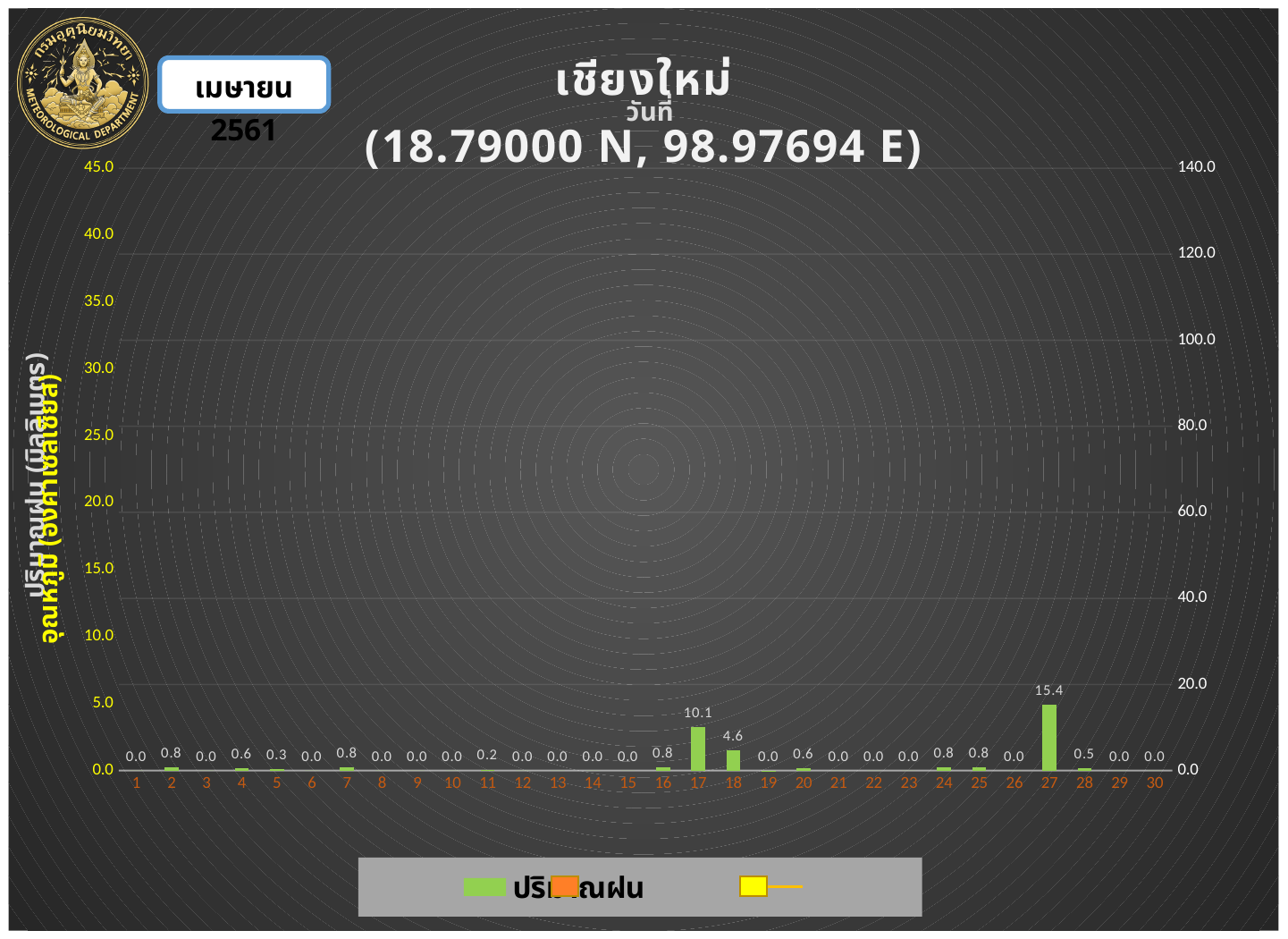
What coordinates are given in the chart title? 18.79000 N, 98.97694 E What kind of chart is shown on the slide? bar chart Which day has the larger rainfall value, day 17 or day 18? 17 What is the rainfall value shown for day 11? 0.2 What is the difference between the rainfall values for day 27 and day 17? 5.3 What is the difference between the rainfall values for day 17 and day 18? 5.5 Which day has the highest rainfall value? 27 What is the rainfall value shown for day 17? 10.1 What is the rainfall value shown for day 18? 4.6 Is the rainfall value for day 27 greater or less than 20.0 on the right axis? less What is the rainfall value shown for day 27? 15.4 How many days are shown on the x axis? 30